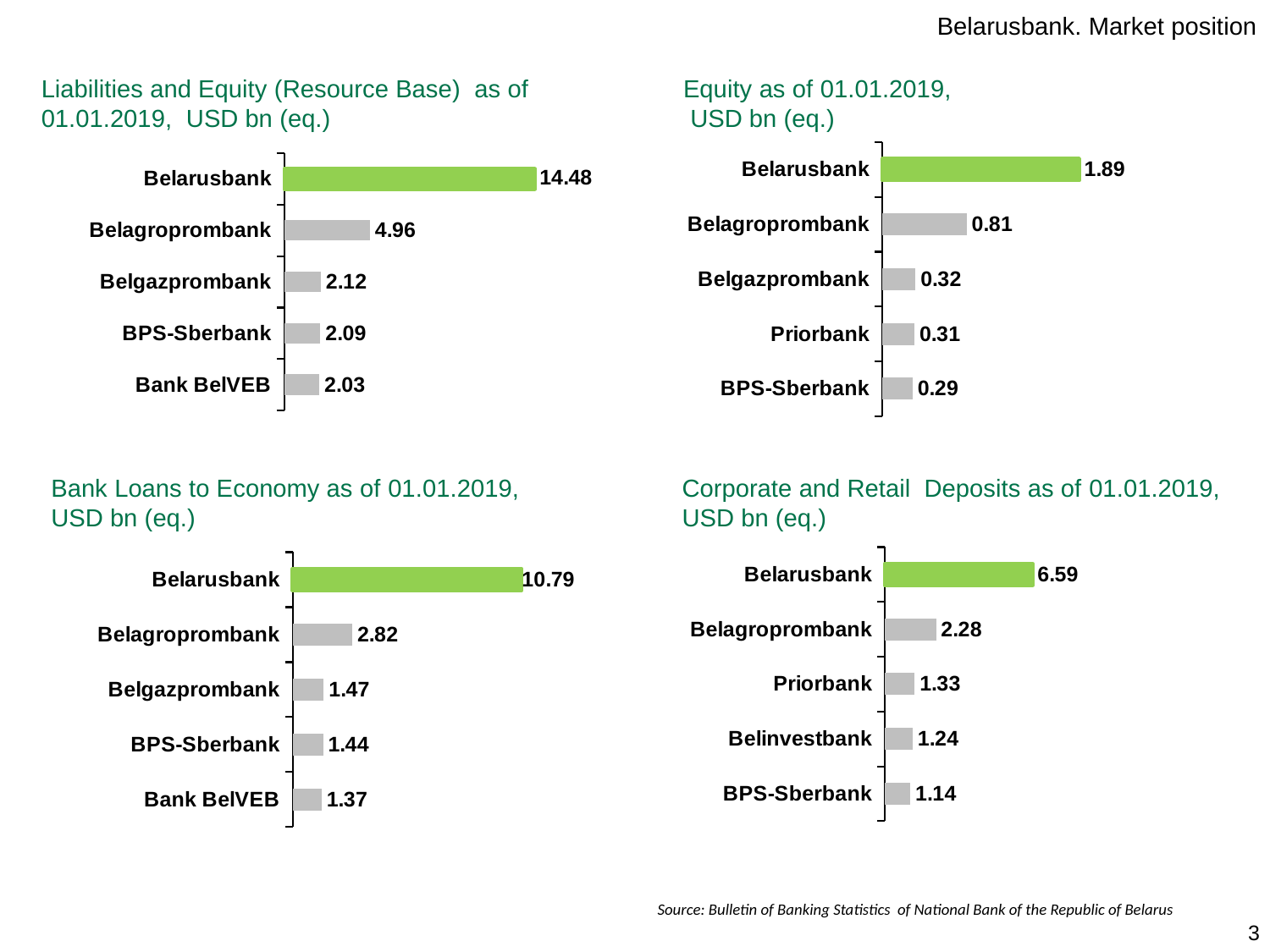
In the 'Bank Loans to Economy' chart, what is the value for Belarusbank? 10.79 In the 'Liabilities and Equity (Resource Base)' chart, which bank has the highest value? Belarusbank In the 'Equity as of 01.01.2019' chart, how many banks are shown? 5 In the 'Corporate and Retail Deposits' chart, what is the value for Belinvestbank? 1.24 In the 'Liabilities and Equity (Resource Base)' chart, what is the value for Belagroprombank? 4.96 In the 'Bank Loans to Economy' chart, what is the difference between Belgazprombank and Bank BelVEB? 0.10 In the 'Equity as of 01.01.2019' chart, which bank has the lowest value? BPS-Sberbank In the 'Liabilities and Equity (Resource Base)' chart, what is the difference between Belarusbank and Belagroprombank? 9.52 In the 'Bank Loans to Economy' chart, which is larger: Belagroprombank or Belgazprombank? Belagroprombank In the 'Equity as of 01.01.2019' chart, what is the value for Priorbank? 0.31 What type of chart is the 'Corporate and Retail Deposits' chart? Bar chart In the 'Corporate and Retail Deposits' chart, what is the difference between Belarusbank and Belagroprombank? 4.31